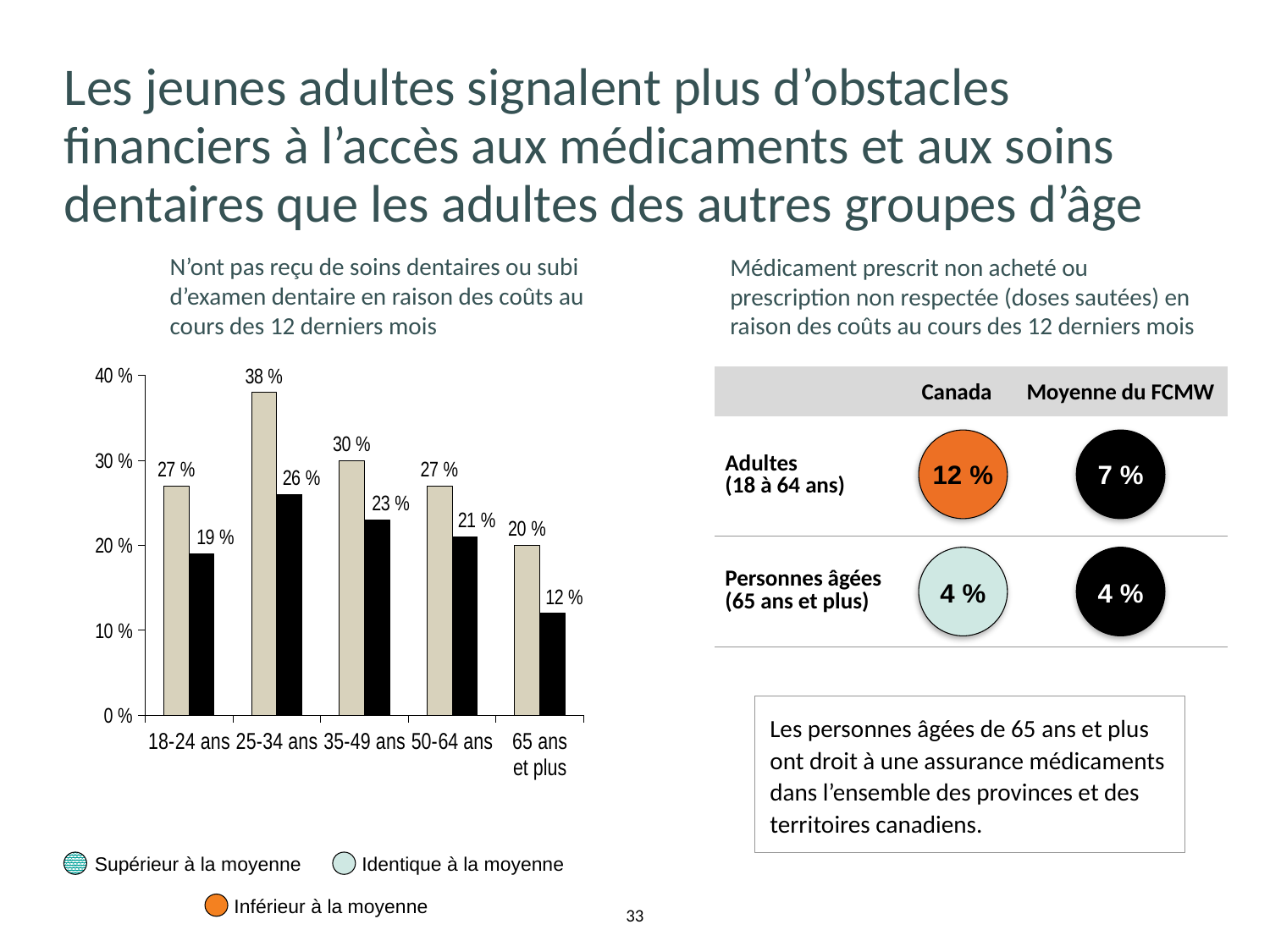
In the bar chart on the left, which age group has the highest beige bar? 25-34 ans In the bar chart on the left, what is the value of the black bar for 65 ans et plus? 12 % What type of chart is shown on the left of the slide? bar chart In the bar chart on the left, which age group has the lowest black bar? 65 ans et plus In the bar chart on the left, do the black bars rise or fall from 25-34 ans to 65 ans et plus? fall In the bar chart on the left, is the beige bar for 35-49 ans greater or less than 20 %? greater In the bar chart on the left, what is the difference between the beige and black bars for 18-24 ans? 8 % In the bar chart on the left, what is the value of the beige bar for 25-34 ans? 38 % In the bar chart on the left, which is larger: the black bar for 25-34 ans or the black bar for 50-64 ans? 25-34 ans In the bar chart on the left, what is the value of the black bar for 35-49 ans? 23 % How many age groups are shown on the x axis of the bar chart on the left? 5 In the bar chart on the left, what is the difference between the beige bar for 25-34 ans and the beige bar for 65 ans et plus? 18 %